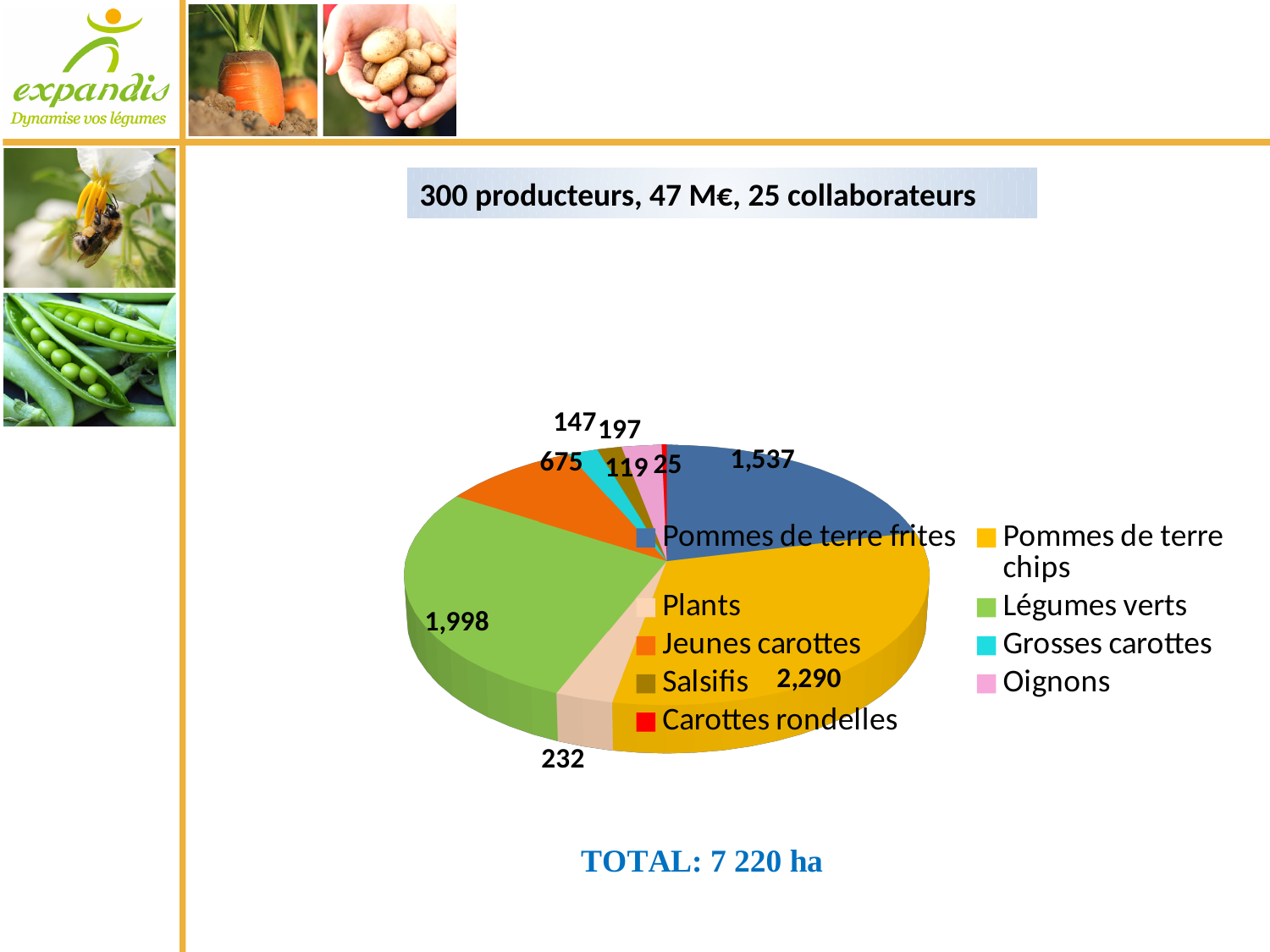
Which category has the smallest slice of the pie? Carottes rondelles What is the value for Pommes de terre frites? 1,537 What total is stated below the pie chart? TOTAL: 7 220 ha How many categories does the pie chart have? 9 What is the difference between the values for Pommes de terre chips and Légumes verts? 292 Which is larger, Légumes verts or Pommes de terre frites? Légumes verts Which category has the largest slice of the pie? Pommes de terre chips What is the value for Pommes de terre chips? 2,290 What is the value for Plants? 232 What is the value for Jeunes carottes? 675 What kind of chart is shown on the slide? Pie chart What is the value for Légumes verts? 1,998